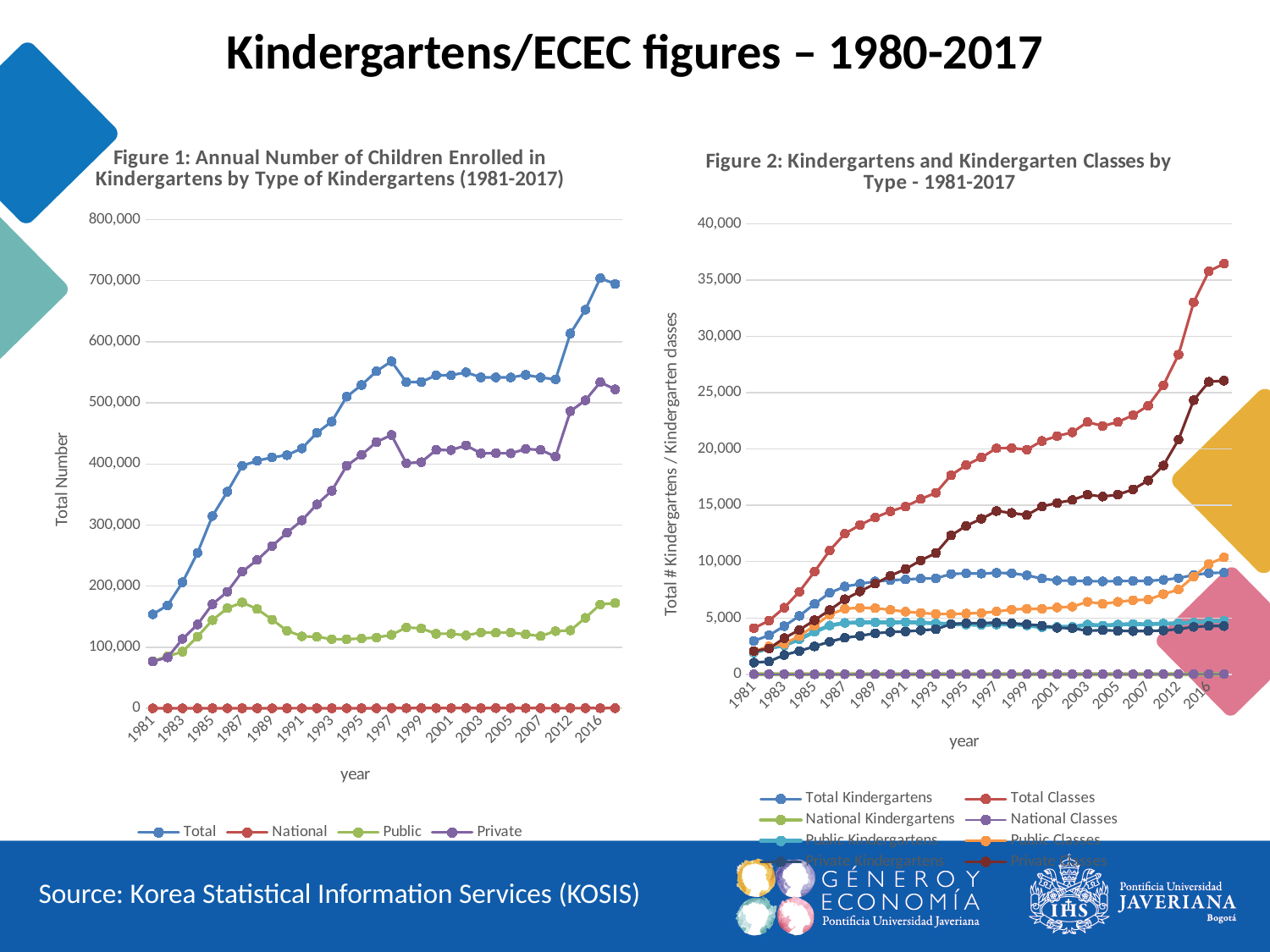
In Figure 2 (kindergartens and classes), does the Total Classes series generally rise or fall from 1981 to 2017? Rise In Figure 1 (children enrolled), which series has the highest value in 2016? Total In Figure 2 (kindergartens and classes), is the value for Total Classes in 2016 greater or less than 35,000? greater In Figure 1 (children enrolled), is the value for Total in 2016 greater or less than 600,000? greater What kind of chart is Figure 1: Annual Number of Children Enrolled in Kindergartens by Type of Kindergartens? Line chart How many series does the legend of Figure 2 (Kindergartens and Kindergarten Classes by Type) list? 8 How many series does the legend of Figure 1 (children enrolled by type of kindergarten) list? 4 What is the y-axis label of Figure 1 (children enrolled by type of kindergarten)? Total Number In Figure 1 (children enrolled), which is larger in 2016, Private or Public? Private In Figure 1 (children enrolled), is the value for Private in 1981 greater or less than 100,000? less